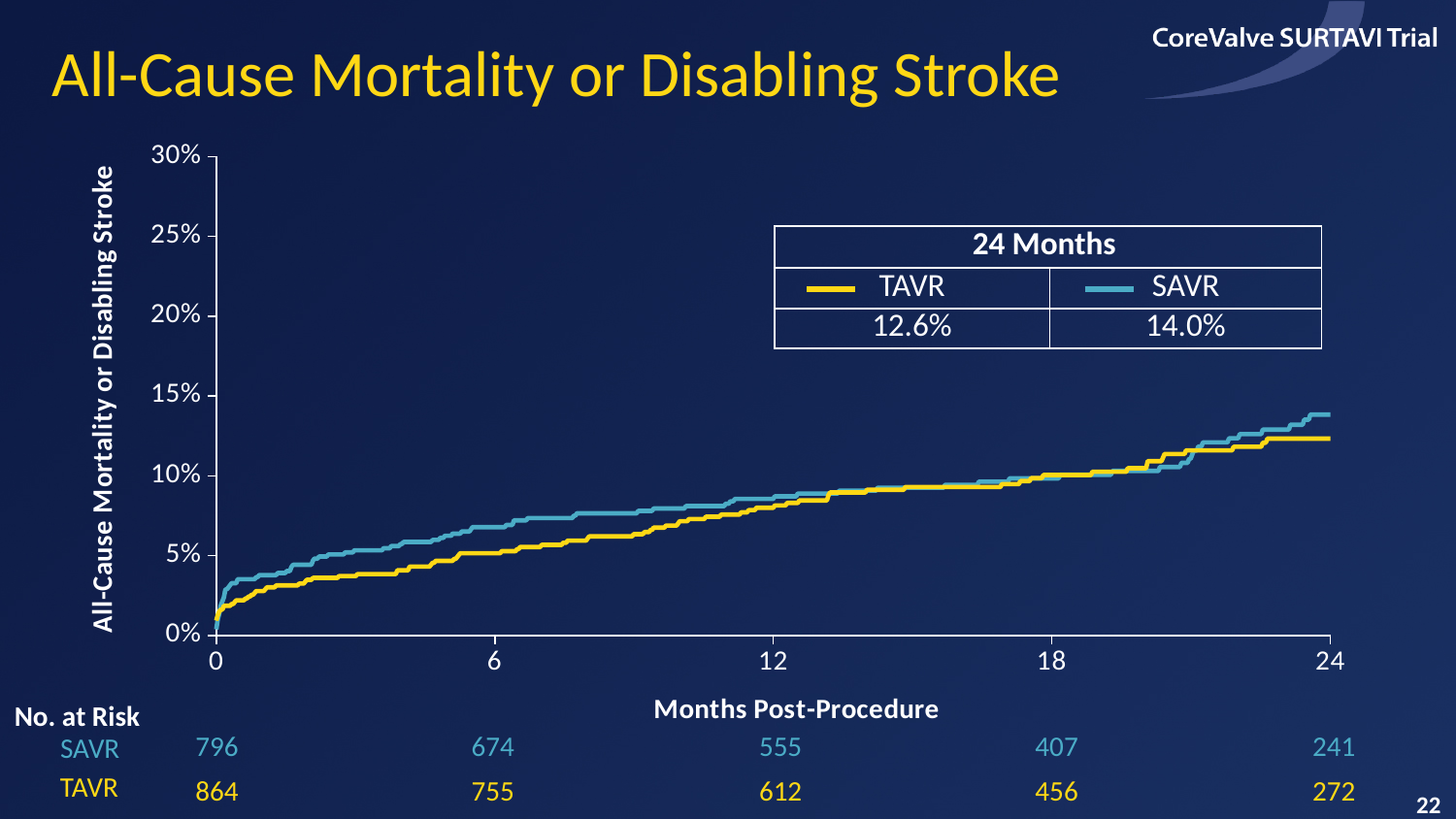
How many series does the legend list? 2 What is the title of the chart? All-Cause Mortality or Disabling Stroke Do the curves rise or fall as months post-procedure increase? Rise What is the difference between the SAVR and TAVR rates at 24 months? 1.4% What is the all-cause mortality or disabling stroke rate for SAVR at 24 months? 14.0% Is the SAVR value at 12 months greater or less than 10%? less Which group has the higher rate at 24 months, TAVR or SAVR? SAVR What is the all-cause mortality or disabling stroke rate for TAVR at 24 months? 12.6% How many SAVR patients were at risk at 18 months? 407 What kind of chart is shown on the slide? Line chart How many TAVR patients were at risk at 0 months? 864